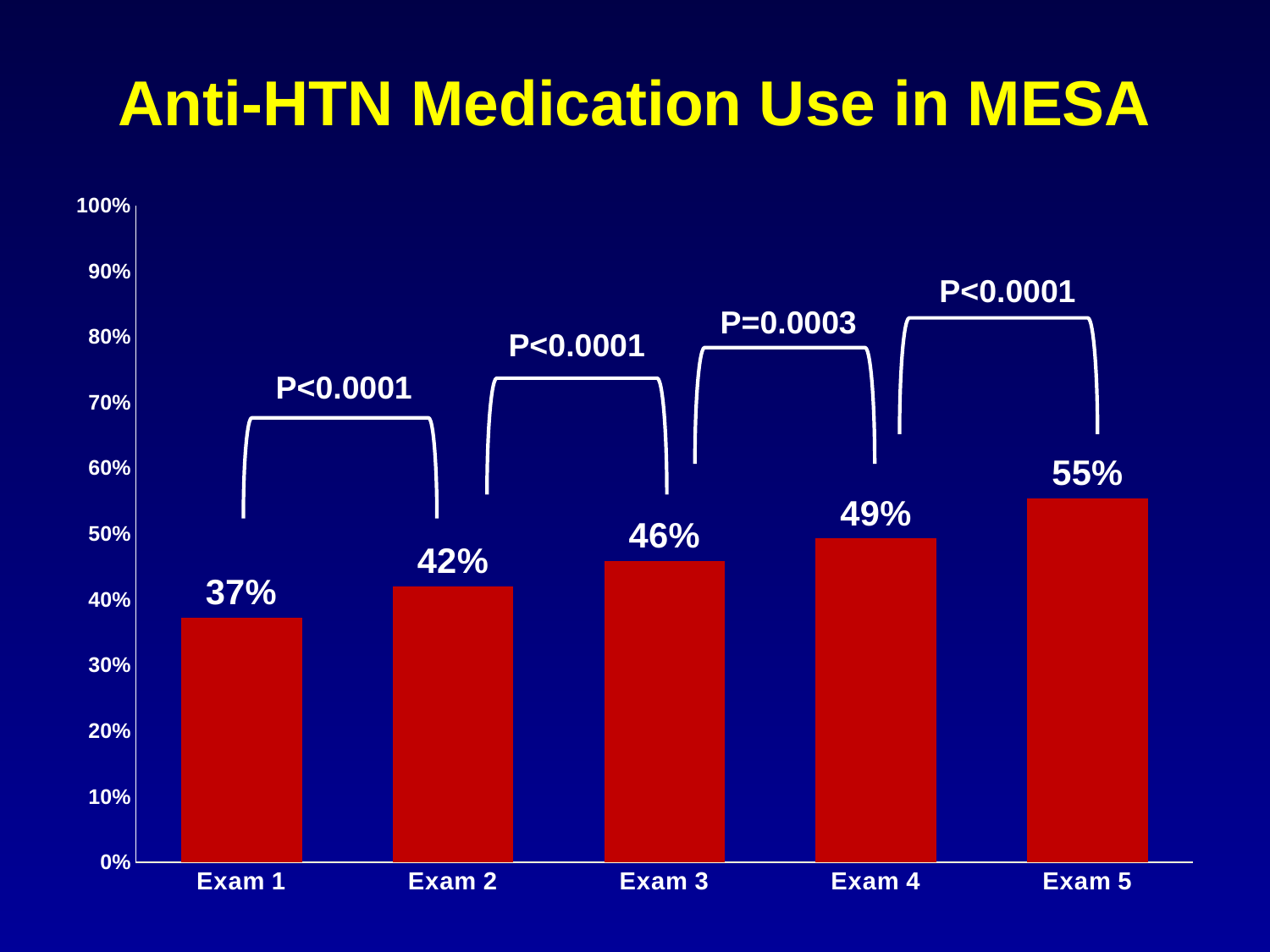
Which exam has the lowest anti-HTN medication use? Exam 1 Is the value for Exam 3 greater or less than 50%? less What is the difference between the values for Exam 4 and Exam 2? 7% What is the value for Exam 3? 46% What is the value for Exam 5? 55% What is the difference between the values for Exam 5 and Exam 1? 18% Do the values rise or fall from Exam 1 to Exam 5? rise What is the value for Exam 1? 37% Which is larger, the value for Exam 2 or the value for Exam 4? Exam 4 What kind of chart is shown on the slide? bar chart Which exam has the highest anti-HTN medication use? Exam 5 How many exams are shown on the x axis? 5